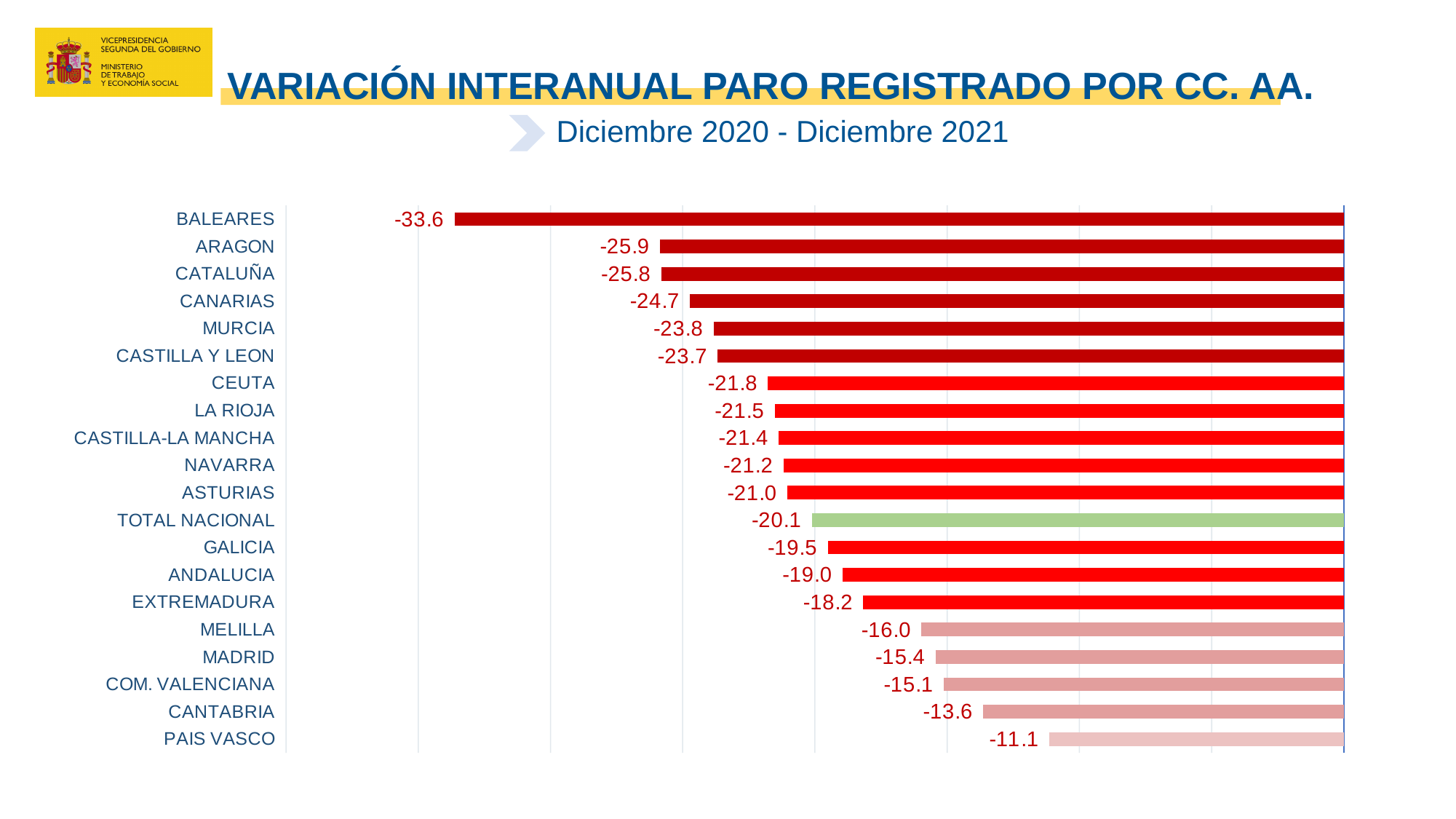
What is the value shown for BALEARES? -33.6 What is the value shown for MADRID? -15.4 Which bar is coloured green instead of red? TOTAL NACIONAL Which region shows the smallest decrease (the value closest to zero)? PAIS VASCO What is the value shown for CASTILLA-LA MANCHA? -21.4 Which has a larger decrease, ARAGON or CANARIAS? ARAGON What is the difference between the values for BALEARES and PAIS VASCO? 22.5 What kind of chart is shown on the slide? Bar chart How many categories (bars) are shown in the chart? 20 Which region shows the largest decrease (the most negative value)? BALEARES What is the value shown for TOTAL NACIONAL? -20.1 What is the difference between the values for MADRID and CANTABRIA? 1.8